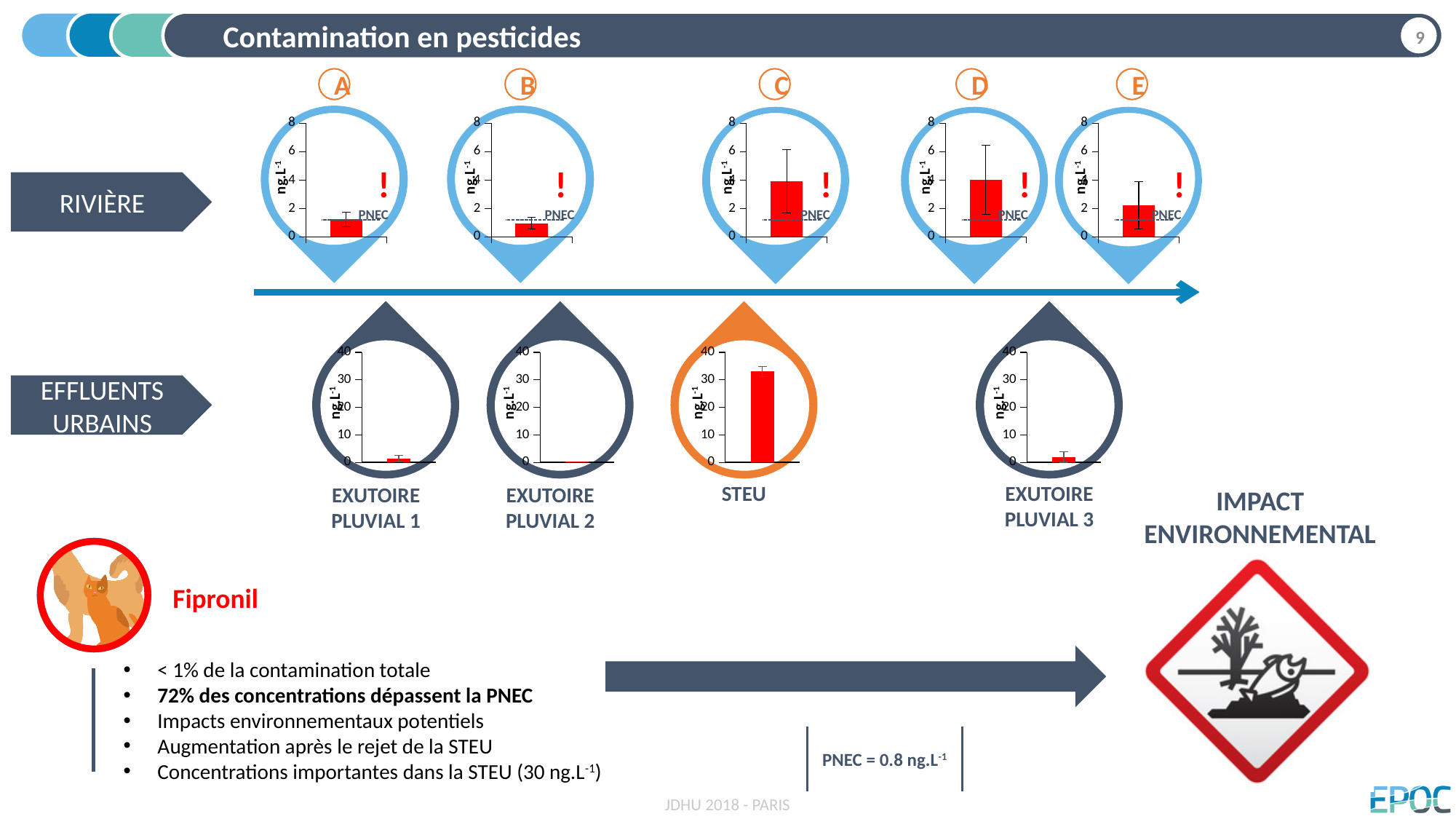
What kind of chart is used in each of the RIVIÈRE circles (A to E)? bar chart Which bar is larger: the STEU chart or the EXUTOIRE PLUVIAL 2 chart? STEU How many bar charts are shown in the RIVIÈRE row? 5 How many bar charts are shown in the EFFLUENTS URBAINS row? 4 In the EFFLUENTS URBAINS STEU chart, is the bar value greater or less than 20? greater In the RIVIÈRE chart A, is the bar value greater or less than 2? less Which bar is larger: RIVIÈRE chart C or RIVIÈRE chart A? C In the RIVIÈRE chart E, is the bar value greater or less than 4? less Among the EFFLUENTS URBAINS charts, which site has the highest bar? STEU What unit is shown on the y-axis of the charts? ng.L-1